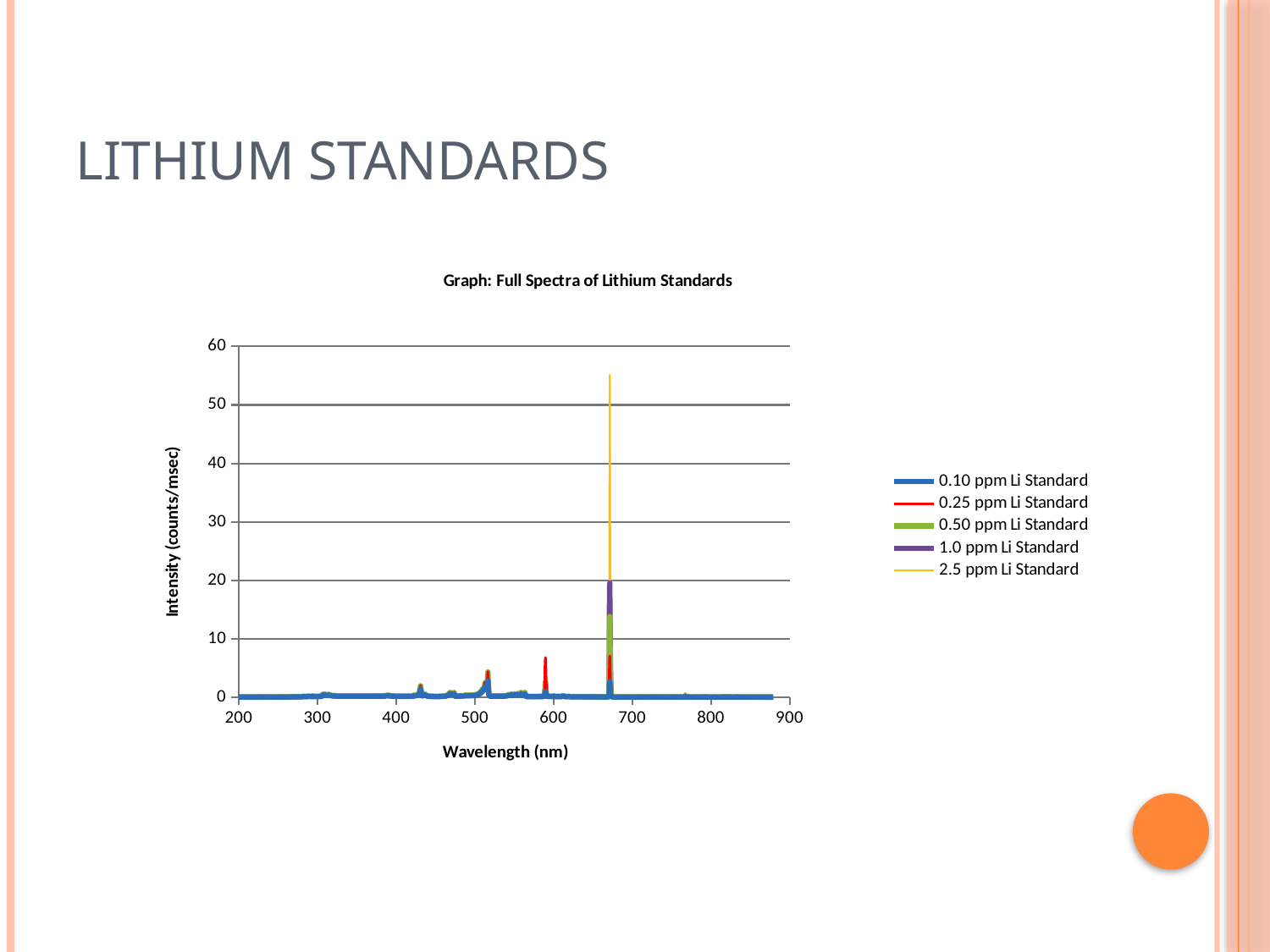
What kind of chart is shown on the slide? Line chart How many series does the legend list? 5 What is the title of the chart? Graph: Full Spectra of Lithium Standards What is the label of the y axis? Intensity (counts/msec) Which series reaches the highest peak intensity? 2.5 ppm Li Standard Which has a higher peak intensity, the 0.50 ppm Li Standard or the 0.25 ppm Li Standard? 0.50 ppm Li Standard Is the peak intensity of the 2.5 ppm Li Standard greater or less than 50? greater Is the peak intensity of the 0.50 ppm Li Standard greater or less than 20? less Which has a higher peak intensity, the 2.5 ppm Li Standard or the 1.0 ppm Li Standard? 2.5 ppm Li Standard Is the peak intensity of the 0.50 ppm Li Standard greater or less than 10? greater